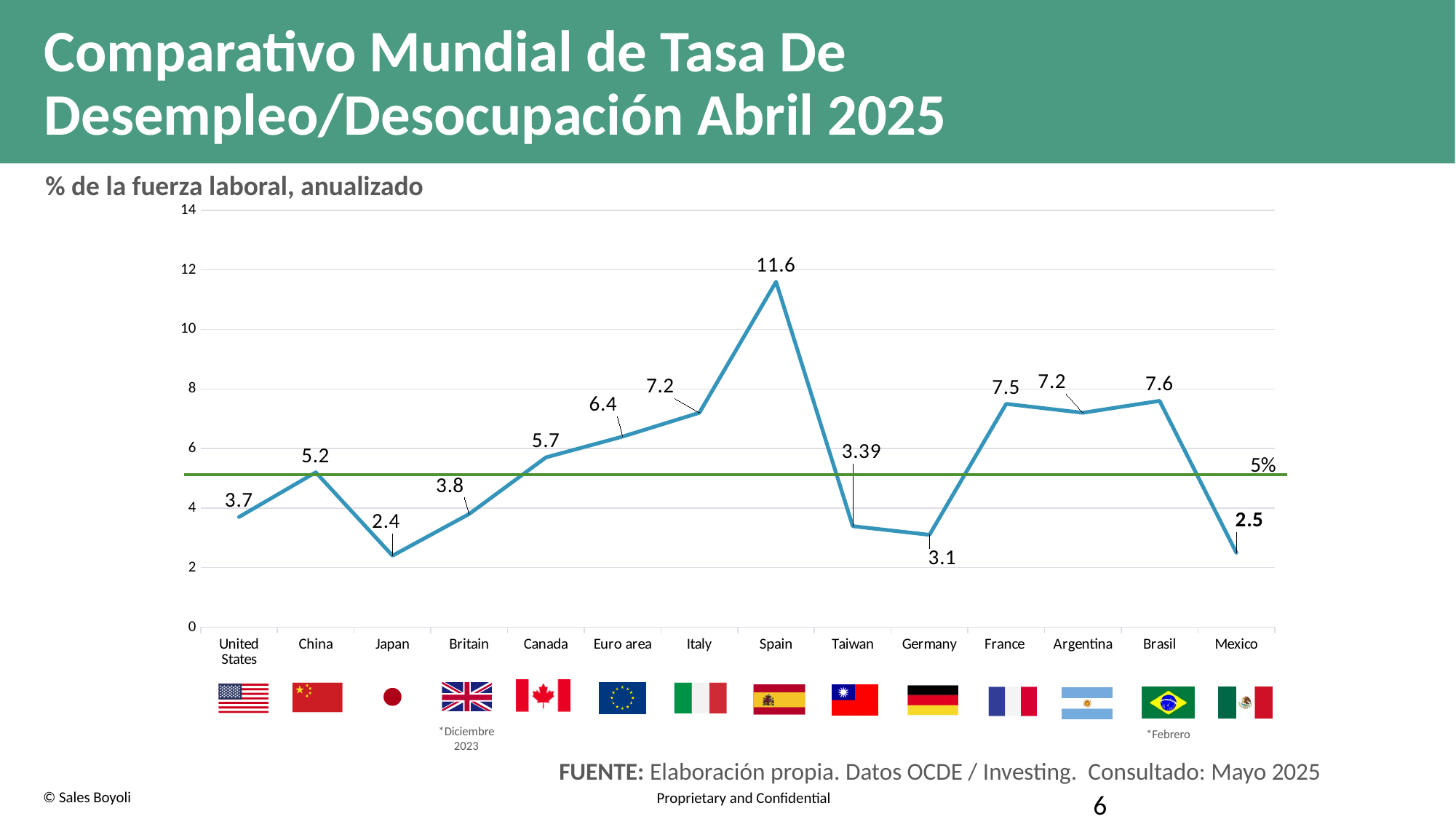
Which has a higher value, Brasil or France? Brasil How many countries or regions are plotted on the chart? 14 Which country has the lowest unemployment rate on the chart? Japan What is the value shown for Mexico? 2.5 Is the value for Canada greater or less than 5? greater What is the value shown for Taiwan? 3.39 What is the unemployment rate shown for Spain? 11.6 What kind of chart is shown on the slide? Line chart What is the subtitle describing the unit of the chart? % de la fuerza laboral, anualizado What value does the horizontal green reference line mark? 5% Which country has the highest unemployment rate on the chart? Spain What is the difference between the values for Spain and Japan? 9.2